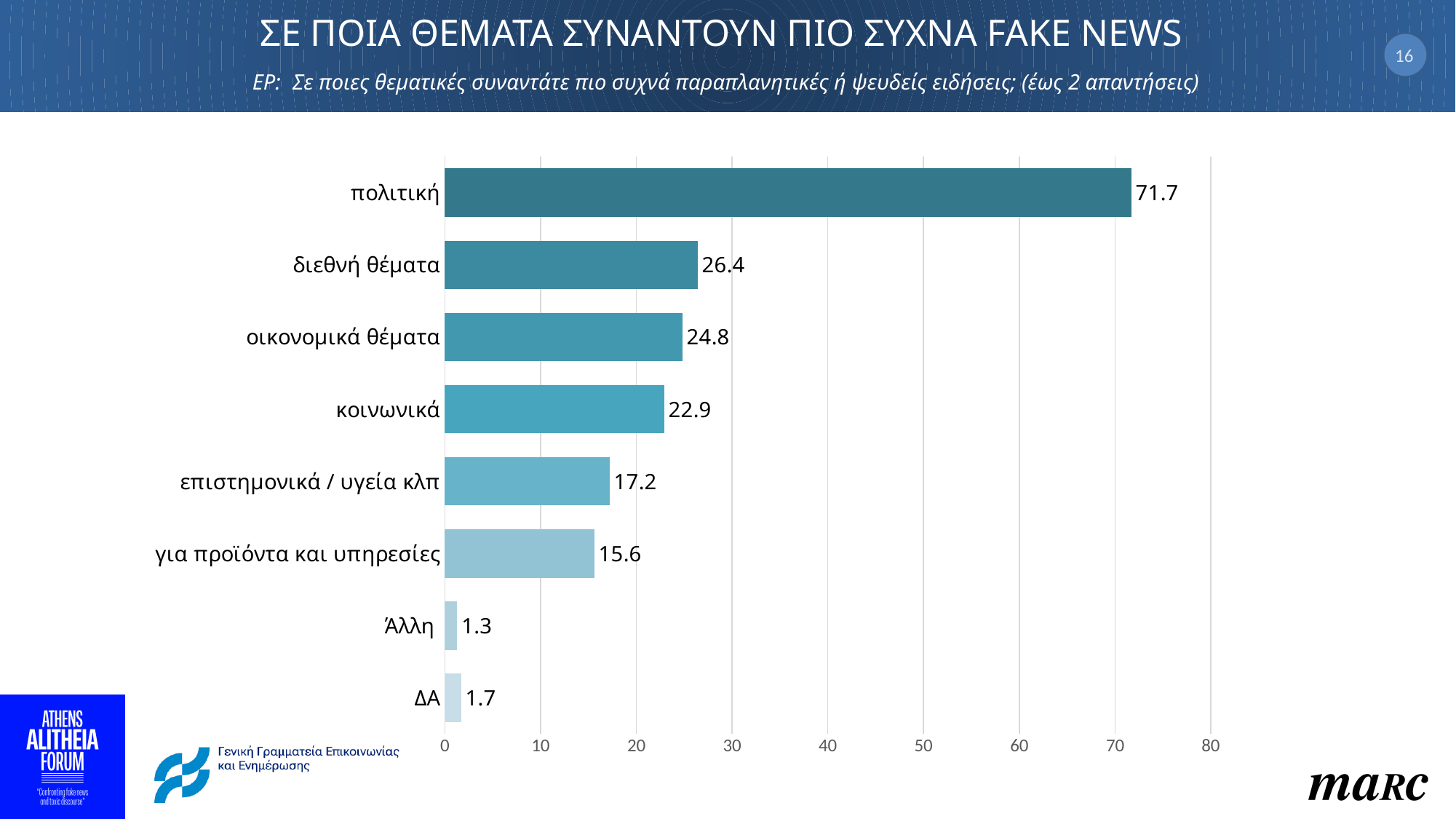
Which category has the lowest value? Άλλη What is the value for επιστημονικά / υγεία κλπ? 17.2 Which is larger, the value for κοινωνικά or the value for για προϊόντα και υπηρεσίες? κοινωνικά Which category has the highest value? πολιτική Is the value for πολιτική greater or less than 70? greater What is the difference between the values for πολιτική and διεθνή θέματα? 45.3 What kind of chart is shown on the slide? bar chart How many categories are shown in the chart? 8 What is the difference between the values for οικονομικά θέματα and κοινωνικά? 1.9 What is the value for πολιτική? 71.7 What is the value for διεθνή θέματα? 26.4 What is the value for ΔΑ? 1.7